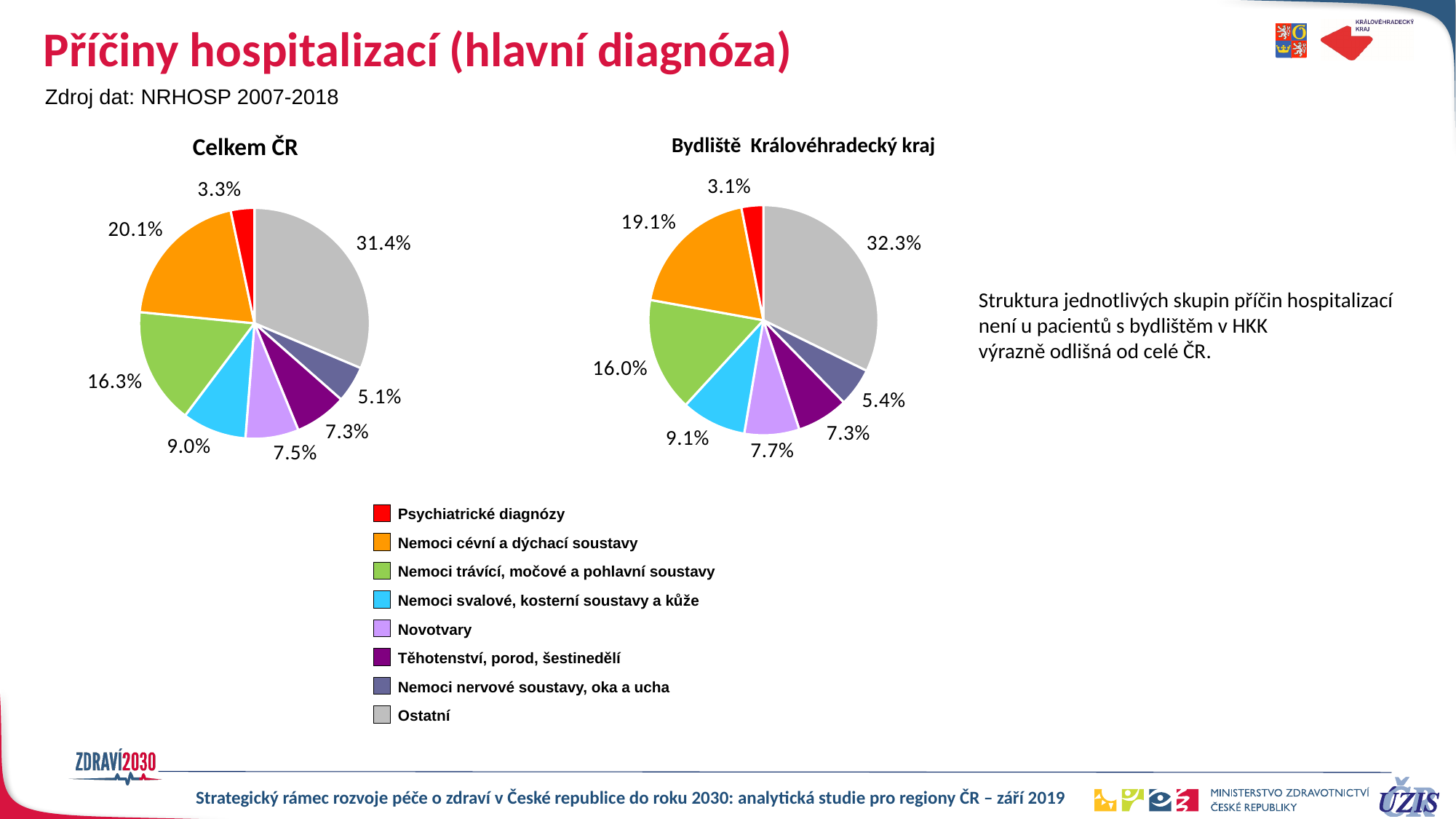
In the 'Celkem ČR' chart, which category has the largest share? Ostatní What is the difference between the share of 'Nemoci cévní a dýchací soustavy' in the 'Celkem ČR' chart and in the 'Bydliště Královéhradecký kraj' chart? 1.0% In the 'Bydliště Královéhradecký kraj' chart, what share do 'Novotvary' have? 7.7% In the 'Celkem ČR' chart, what share do 'Nemoci cévní a dýchací soustavy' have? 20.1% In the 'Celkem ČR' chart, what share do 'Psychiatrické diagnózy' have? 3.3% Is the share of 'Nemoci trávící, močové a pohlavní soustavy' larger in the 'Celkem ČR' chart or in the 'Bydliště Královéhradecký kraj' chart? Celkem ČR In the 'Bydliště Královéhradecký kraj' chart, what share does 'Ostatní' have? 32.3% In the 'Bydliště Královéhradecký kraj' chart, which category has the smallest share? Psychiatrické diagnózy In the 'Celkem ČR' chart, which is larger: 'Nemoci svalové, kosterní soustavy a kůže' or 'Novotvary'? Nemoci svalové, kosterní soustavy a kůže What type of chart is used for 'Celkem ČR'? Pie chart Which colour represents 'Těhotenství, porod, šestinedělí' in the legend? Dark purple How many categories does each pie chart on the slide contain? 8